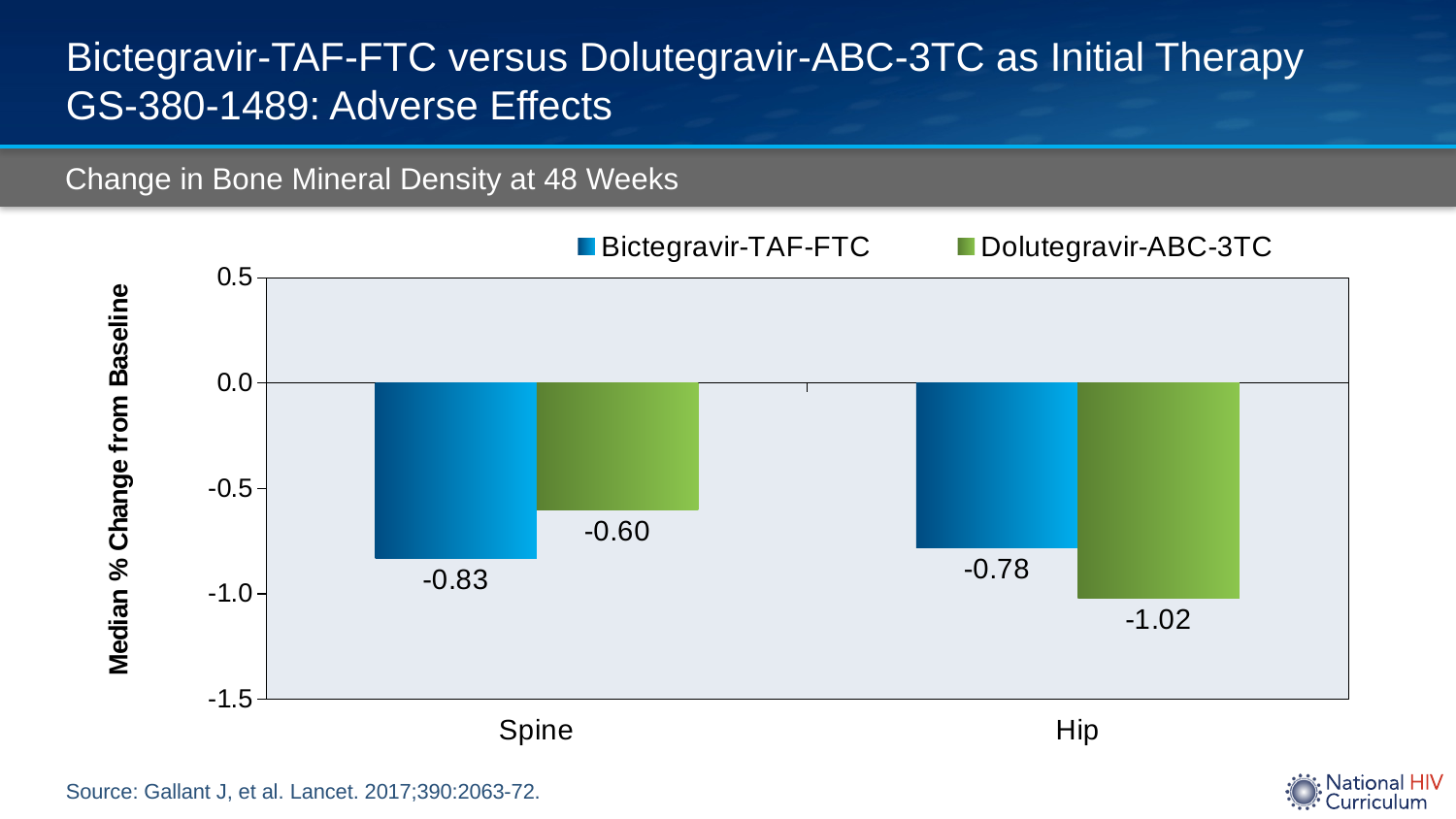
Which bar shows the lowest (most negative) median % change from baseline? Dolutegravir-ABC-3TC at the hip What is the median % change from baseline in bone mineral density at the hip for Dolutegravir-ABC-3TC? -1.02 How many categories are shown on the x axis? 2 What is the median % change from baseline at the hip for Bictegravir-TAF-FTC? -0.78 What is the median % change from baseline at the spine for Dolutegravir-ABC-3TC? -0.60 What is the difference between the Bictegravir-TAF-FTC and Dolutegravir-ABC-3TC values at the spine? 0.23 What is the difference between the Bictegravir-TAF-FTC and Dolutegravir-ABC-3TC values at the hip? 0.24 Which bar shows the smallest decline (value closest to zero) in bone mineral density? Dolutegravir-ABC-3TC at the spine How many series does the legend list? 2 What is the median % change from baseline in bone mineral density at the spine for Bictegravir-TAF-FTC? -0.83 At the spine, which regimen shows a larger decline in bone mineral density? Bictegravir-TAF-FTC What kind of chart is shown on the slide? Bar chart